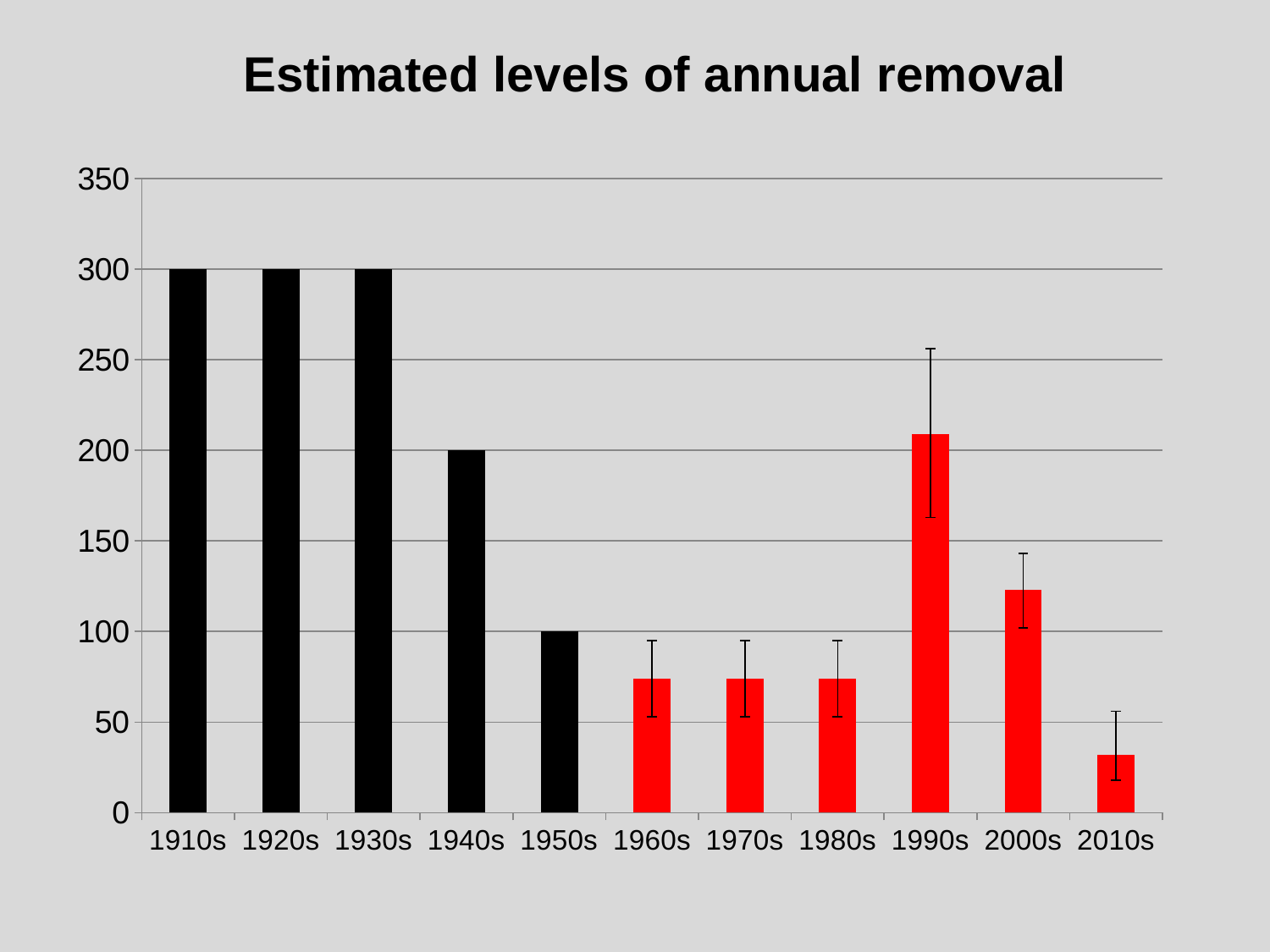
What is the difference between the values for the 1940s and the 1950s? 100 What kind of chart is shown on the slide? Bar chart Is the value for the 1990s greater or less than 200? greater Do the values rise or fall from the 1930s to the 1950s? Fall What is the value for the 1950s? 100 Which decade has the lowest estimated level of annual removal? 2010s Is the value for the 2010s greater or less than 50? less What is the value for the 1940s? 200 Is the value for the 1970s greater or less than 100? less What is the value for the 1920s? 300 Which is larger, the value for the 1990s or the value for the 2000s? 1990s How many decades are shown on the x axis? 11